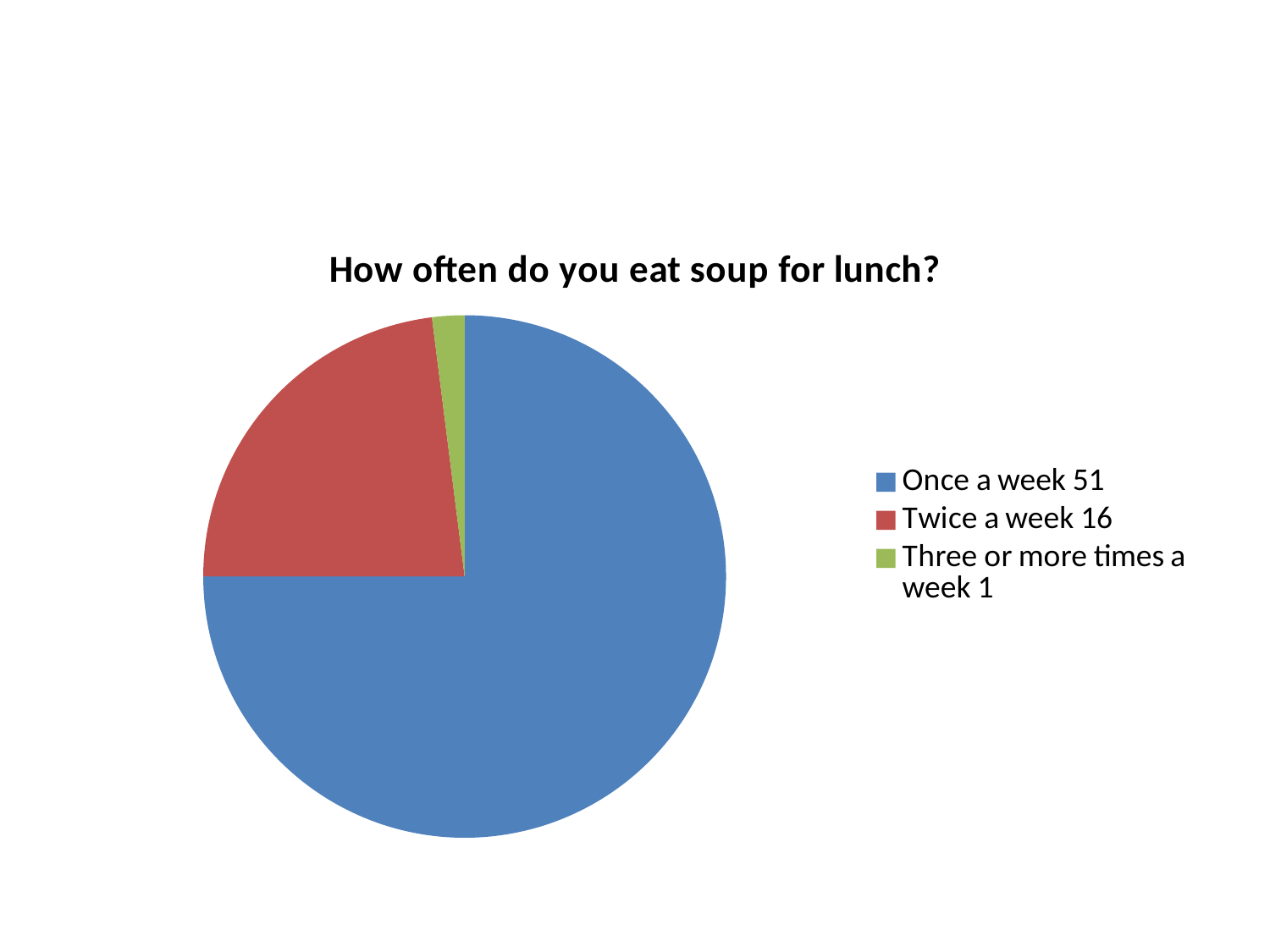
What is the total of all three values in the pie chart? 68 Which category has the largest slice? Once a week What is the value for "Twice a week"? 16 How many slices does the pie chart have? 3 What share of the pie does "Once a week" represent? 75% Which category has the smallest slice? Three or more times a week What is the value for "Three or more times a week"? 1 What is the value for "Once a week"? 51 What is the title of the chart? How often do you eat soup for lunch? What is the difference between the values for "Once a week" and "Twice a week"? 35 Which is larger, the value for "Twice a week" or "Three or more times a week"? Twice a week What kind of chart is shown on the slide? pie chart